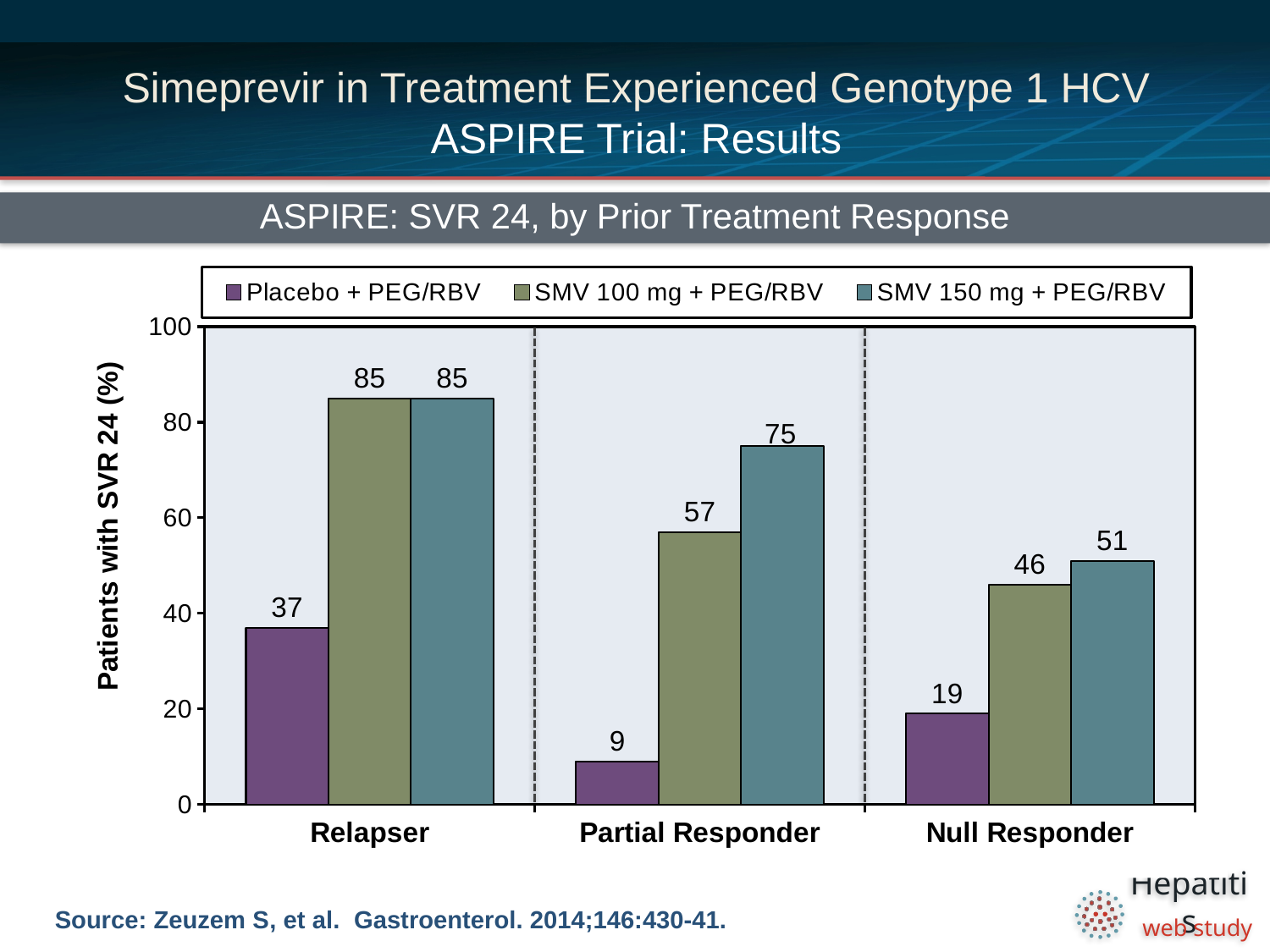
How many series does the legend list? 3 What is the SVR 24 rate for Placebo + PEG/RBV in the Relapser group? 37 What is the difference between the SMV 150 mg + PEG/RBV and Placebo + PEG/RBV SVR 24 rates in the Null Responder group? 32 What is the label of the y axis? Patients with SVR 24 (%) How many prior treatment response groups are shown on the x axis? 3 What kind of chart is shown on the slide? Bar chart Which is larger: the SMV 100 mg + PEG/RBV rate for Partial Responders or the SMV 150 mg + PEG/RBV rate for Null Responders? SMV 100 mg + PEG/RBV for Partial Responders Which prior treatment response group has the highest SMV 150 mg + PEG/RBV SVR 24 rate? Relapser What is the SVR 24 rate for SMV 150 mg + PEG/RBV in the Partial Responder group? 75 Which prior treatment response group has the lowest Placebo + PEG/RBV SVR 24 rate? Partial Responder What is the difference between the SMV 150 mg + PEG/RBV and SMV 100 mg + PEG/RBV SVR 24 rates in the Partial Responder group? 18 What is the SVR 24 rate for SMV 100 mg + PEG/RBV in the Null Responder group? 46